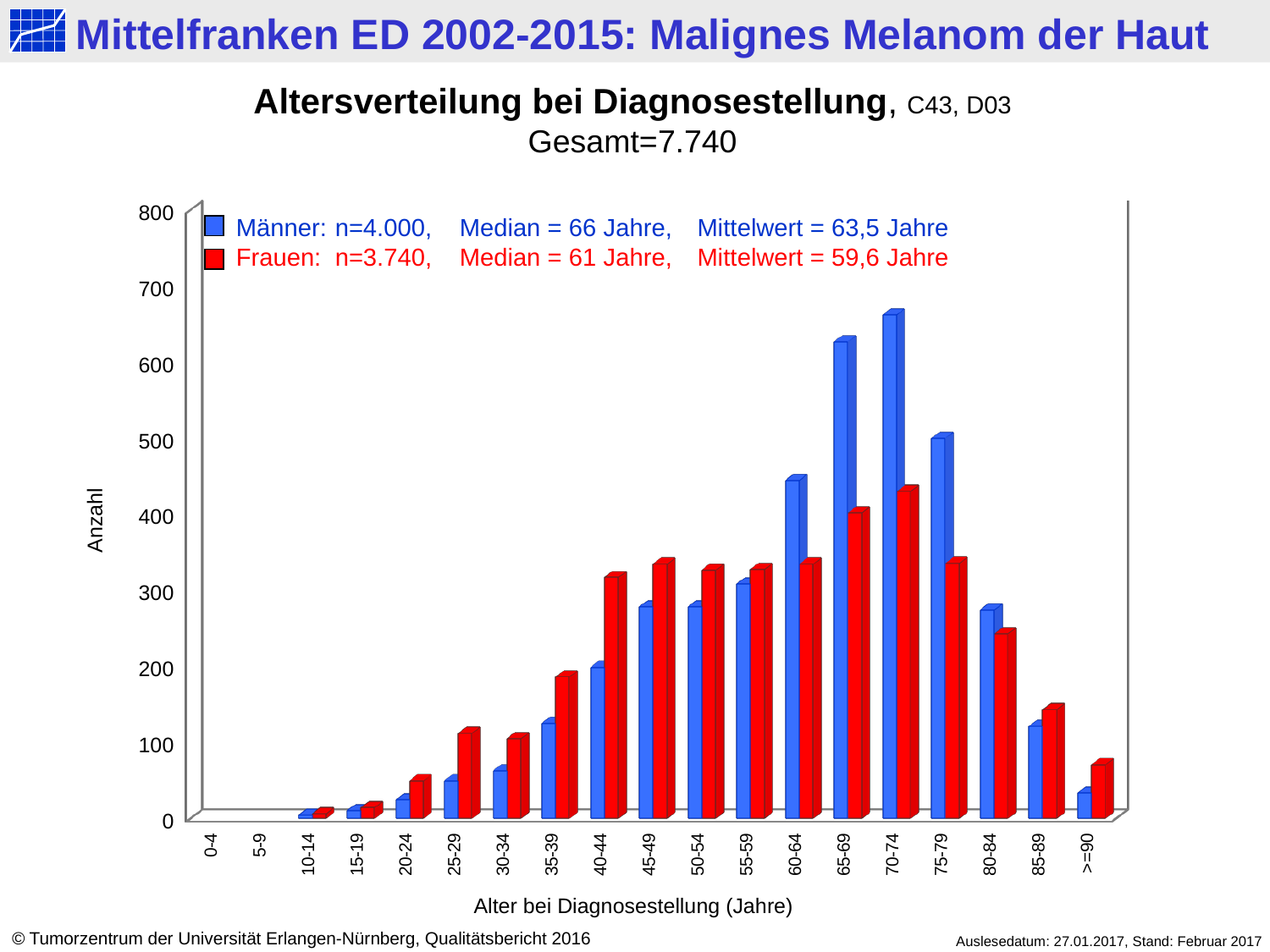
Do the Männer values rise or fall from the 70-74 age group to the >=90 age group? fall Is the value for Frauen in the 70-74 age group greater or less than 400? greater Is the value for Männer in the 60-64 age group greater or less than 500? less Which age group has the highest value for Frauen? 70-74 Is the value for Frauen in the >=90 age group greater or less than 100? less Which age group has the highest value for Männer? 70-74 In the 65-69 age group, which series has the larger value, Männer or Frauen? Männer How many series does the legend list? 2 In the 40-44 age group, which series has the larger value, Männer or Frauen? Frauen What kind of chart is shown on the slide? bar chart How many age categories are shown on the x axis? 19